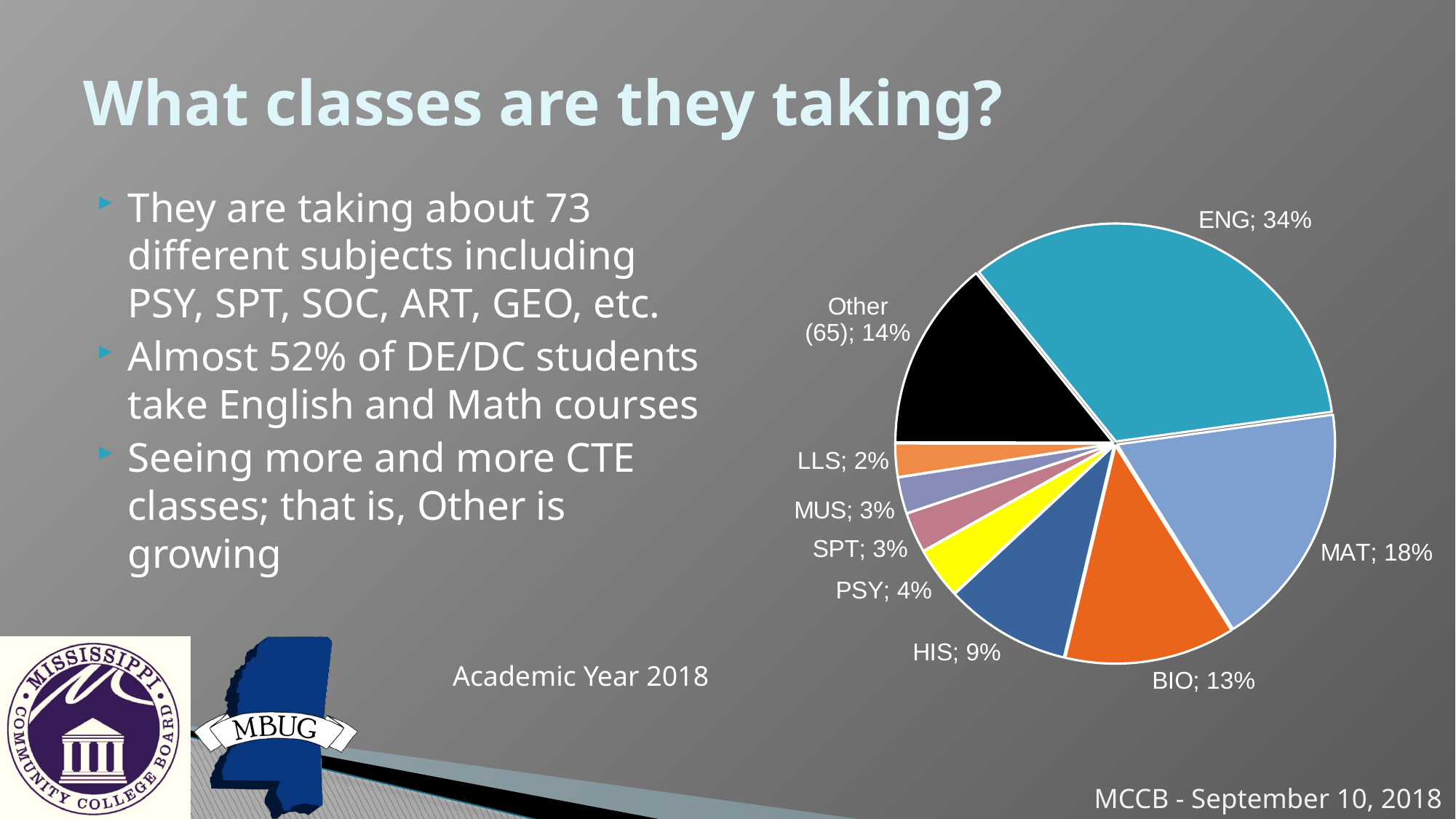
What percentage is shown for BIO? 13% What kind of chart is shown on the slide? Pie chart Which slice of the pie is the smallest? LLS What percentage is shown for HIS? 9% What share of the pie does ENG account for? 34% What percentage is shown for MAT? 18% How many slices does the pie chart have? 9 Which slice of the pie is the largest? ENG What number appears in parentheses in the label for the Other slice? 65 What is the difference in percentage points between ENG and MAT? 16 What percentage is shown for the Other slice? 14% Which is larger, the BIO slice or the HIS slice? BIO